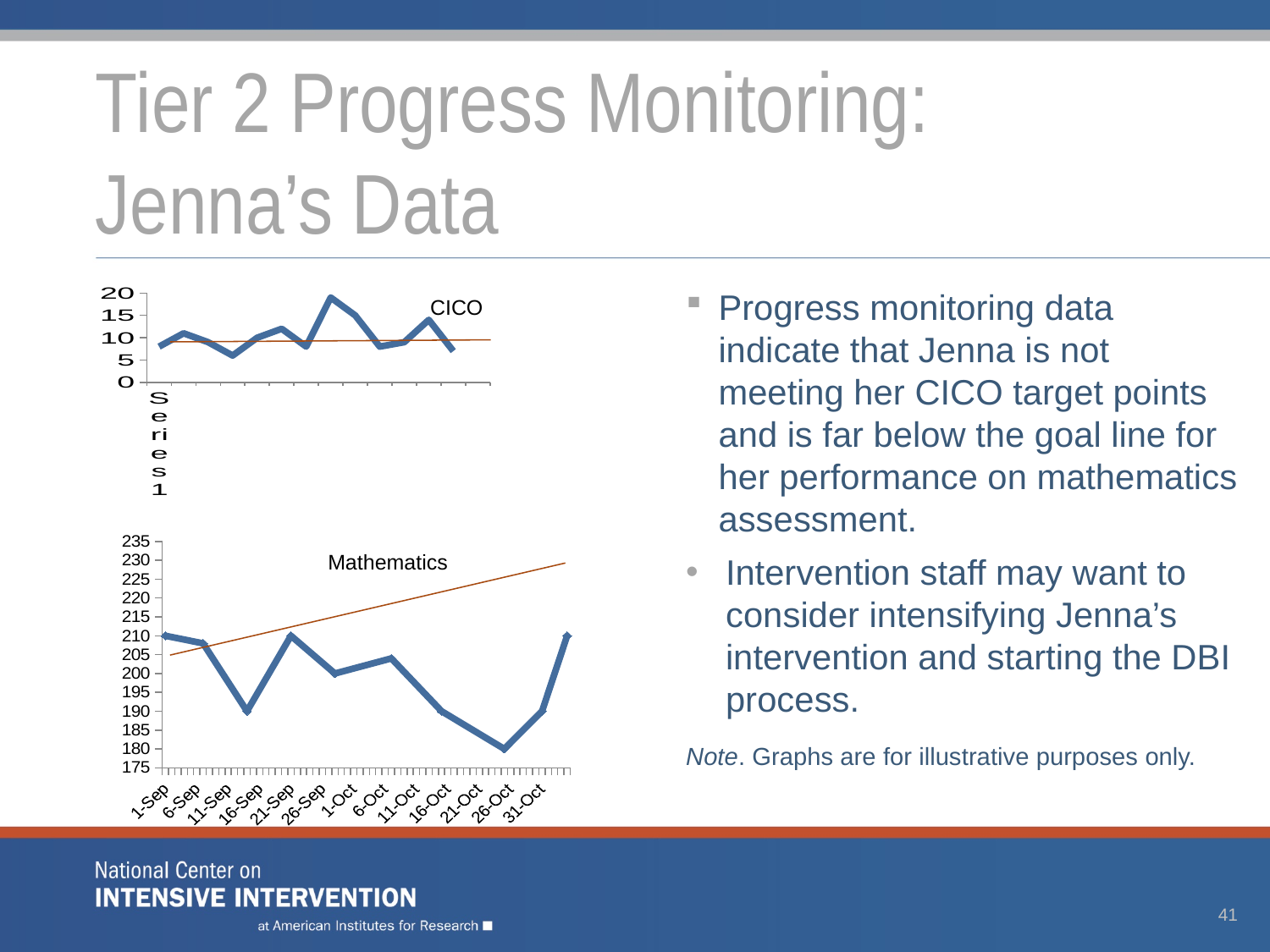
What kind of chart is the Mathematics chart? line chart What is the highest value shown on the y axis of the Mathematics chart? 235 On the Mathematics chart, how many date labels are shown on the x axis? 13 On the Mathematics chart, does the orange goal line rise or fall from left to right? rises On the Mathematics chart, is the lowest point of the blue data line greater or less than 185? less On the Mathematics chart, is the value at 1-Sep greater or less than 205? greater What kind of chart is the CICO chart? line chart On the Mathematics chart, is the highest point of the blue data line greater or less than 205? greater What legend entry is shown on the CICO chart? Series 1